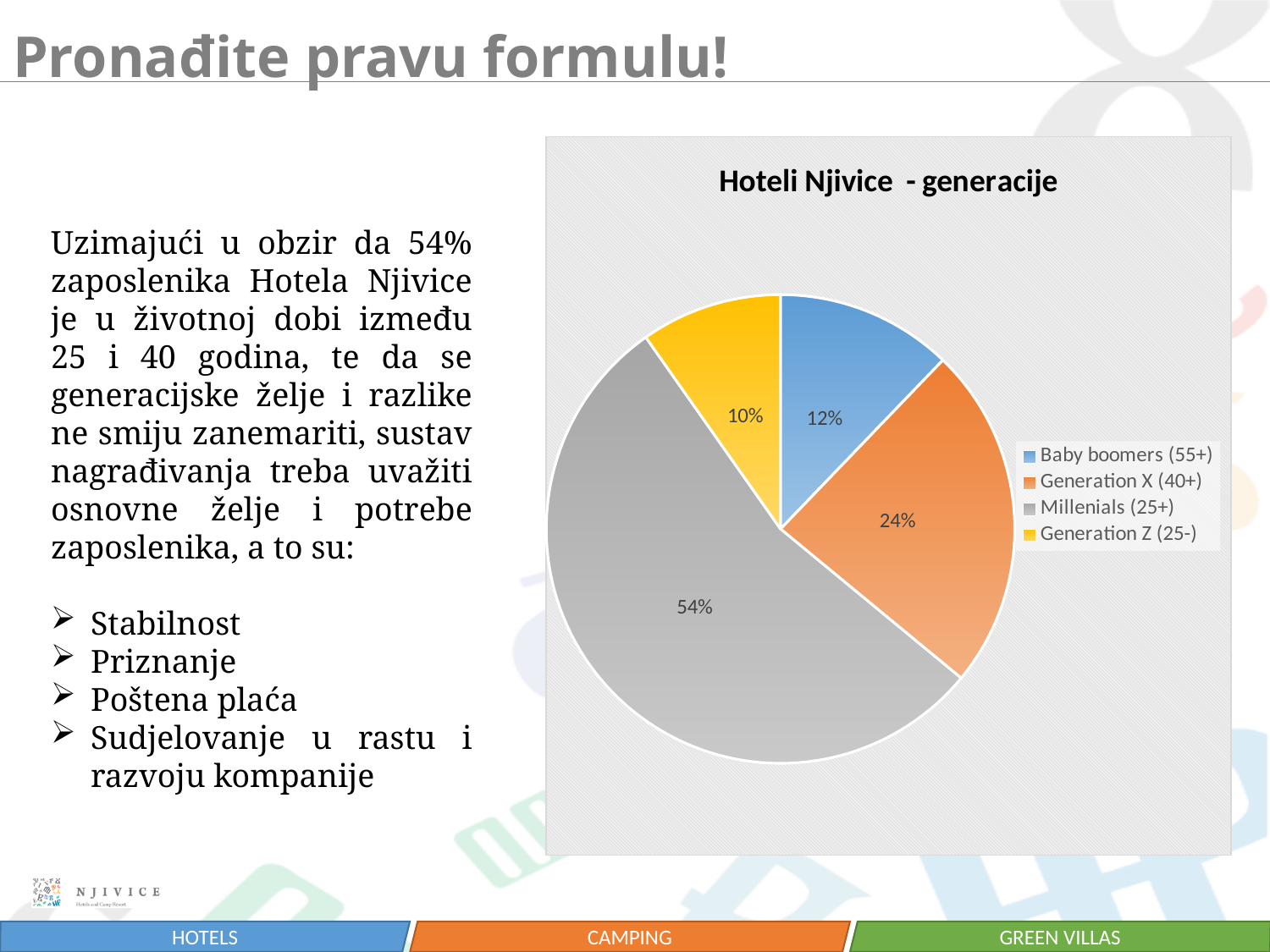
What is the difference in percentage points between Millenials (25+) and Generation X (40+)? 30 What share of the pie is Generation Z (25-)? 10% What share of the pie is Millenials (25+)? 54% What kind of chart is shown on the slide? pie chart Which generation has the smallest slice of the pie? Generation Z (25-) What share of the pie is Baby boomers (55+)? 12% Which is larger, the share for Baby boomers (55+) or the share for Generation Z (25-)? Baby boomers (55+) What share of the pie is Generation X (40+)? 24% How many categories does the legend list? 4 Which generation has the largest slice of the pie? Millenials (25+) What colour is the slice for Generation Z (25-)? yellow What is the title of the chart? Hoteli Njivice - generacije